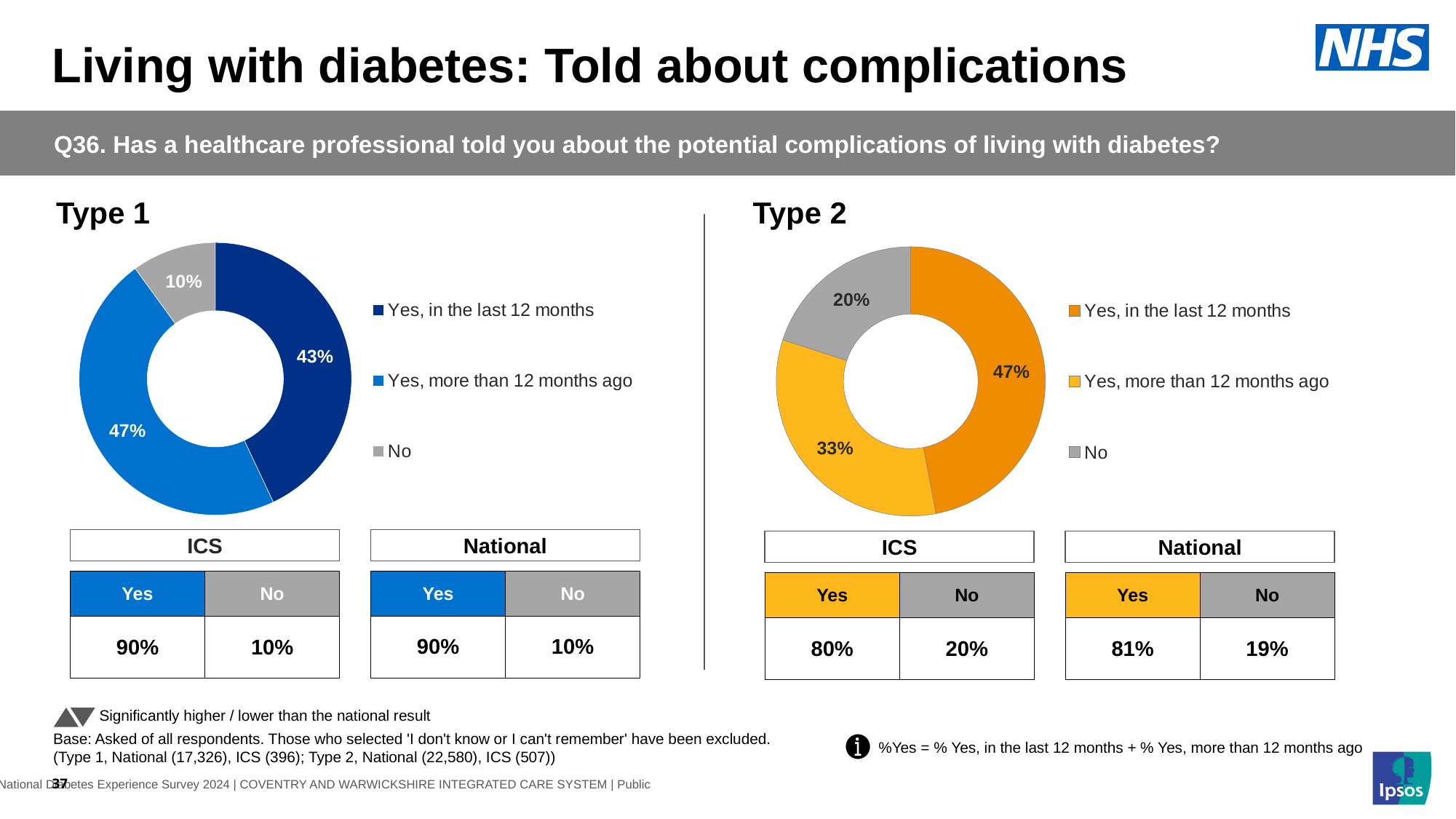
In the Type 1 chart, what percentage of respondents said 'No'? 10% In the Type 2 chart, what is the difference between 'Yes, in the last 12 months' and 'Yes, more than 12 months ago'? 14 percentage points In the Type 2 chart, what colour represents 'Yes, in the last 12 months'? Orange What kind of chart is used to show the Type 1 results? Doughnut (pie) chart How many categories does the legend of the Type 2 chart list? 3 In the Type 1 chart, what is the combined share of the two 'Yes' categories? 90% In the Type 2 chart, what percentage of respondents said 'No'? 20% In the Type 1 chart, which category has the largest share? Yes, more than 12 months ago In the Type 2 chart, which category has the smallest share? No In the Type 1 chart, what percentage of respondents said 'Yes, in the last 12 months'? 43% In the Type 2 chart, what percentage of respondents said 'Yes, more than 12 months ago'? 33% In the Type 1 chart, which is larger: 'Yes, in the last 12 months' or 'Yes, more than 12 months ago'? Yes, more than 12 months ago